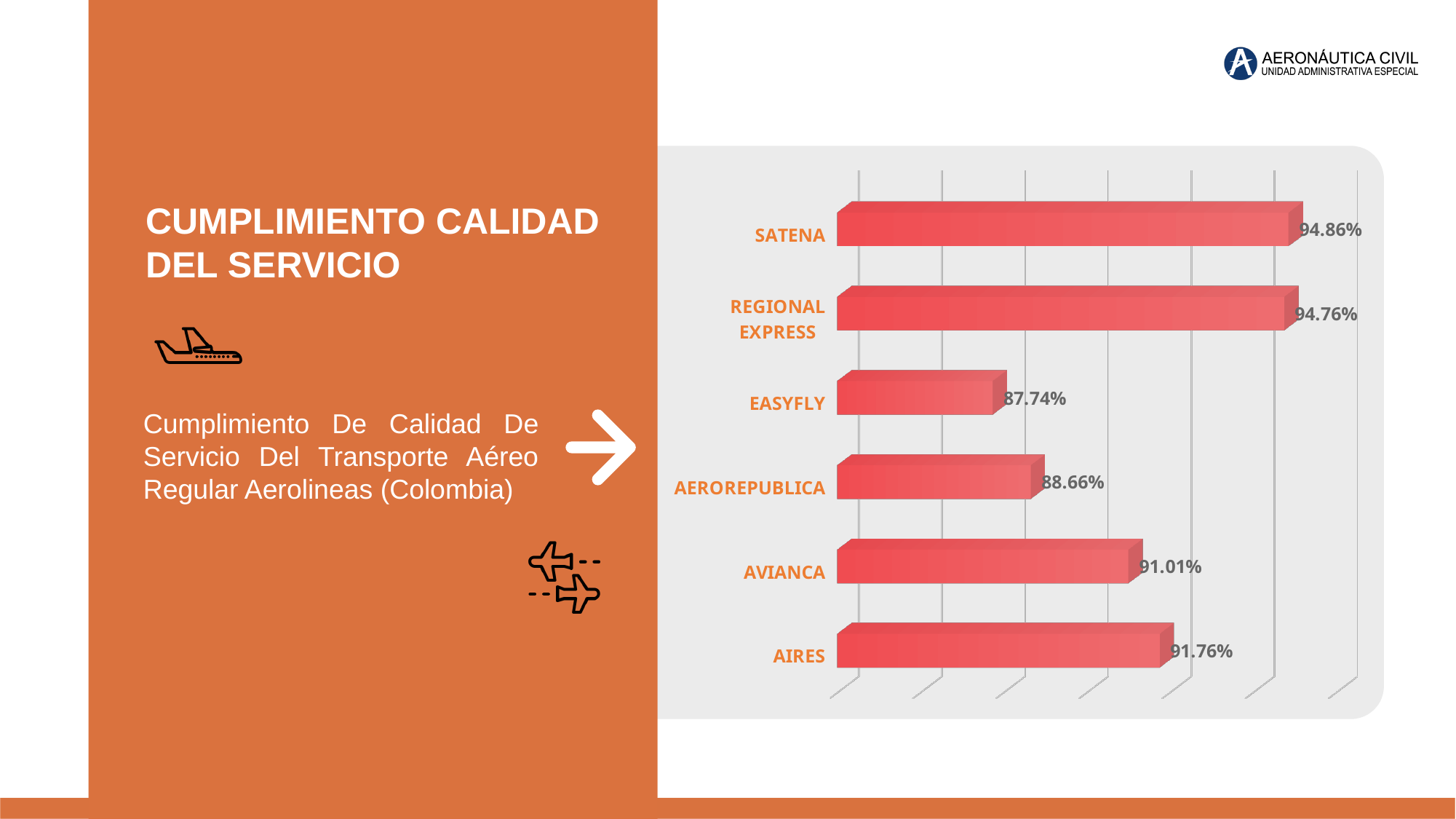
What is the value for AVIANCA? 91.01% What is the value for AIRES? 91.76% What is the value for EASYFLY? 87.74% Which airline has the lowest value? EASYFLY How many airlines are shown in the chart? 6 What kind of chart is shown on the slide? Bar chart Which airline has the highest value? SATENA What is the value for SATENA? 94.86% What is the value for REGIONAL EXPRESS? 94.76% What is the value for AEROREPUBLICA? 88.66% What is the difference between the values for AIRES and AVIANCA? 0.75% Which is larger, the value for AEROREPUBLICA or the value for EASYFLY? AEROREPUBLICA